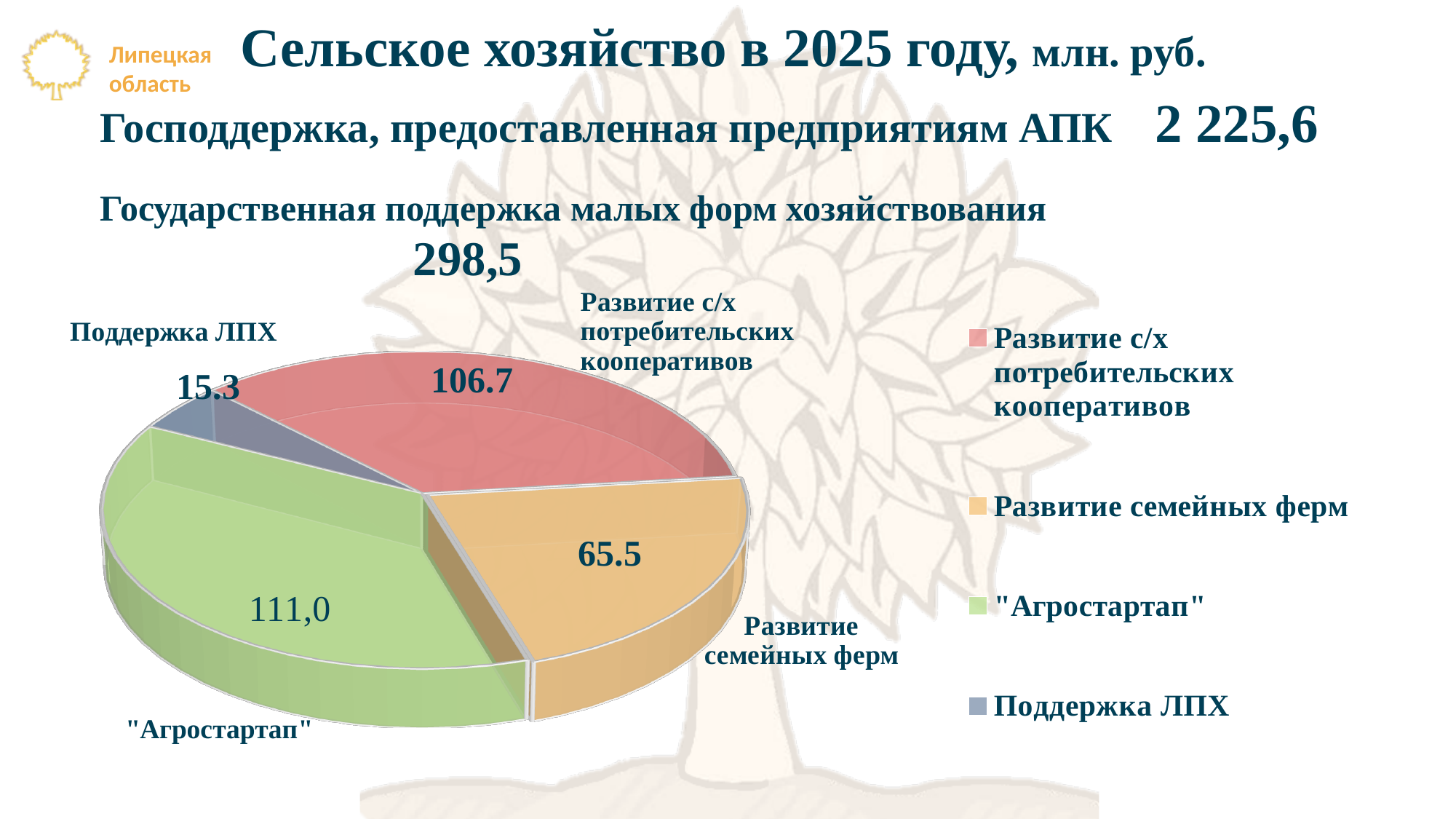
What kind of chart is shown on the slide? pie chart What colour is the slice for Поддержка ЛПХ in the pie chart? blue-grey What is the value for Развитие с/х потребительских кооперативов in the pie chart? 106.7 Which is larger: the value for Развитие семейных ферм or the value for Поддержка ЛПХ? Развитие семейных ферм How many slices does the pie chart have? 4 What is the value for Поддержка ЛПХ in the pie chart? 15.3 What is the value for Развитие семейных ферм in the pie chart? 65.5 Which category has the largest slice in the pie chart? "Агростартап" Which category has the smallest slice in the pie chart? Поддержка ЛПХ What is the value for "Агростартап" in the pie chart? 111,0 What is the difference between the values for Развитие с/х потребительских кооперативов and Развитие семейных ферм? 41.2 How many entries does the legend of the pie chart list? 4